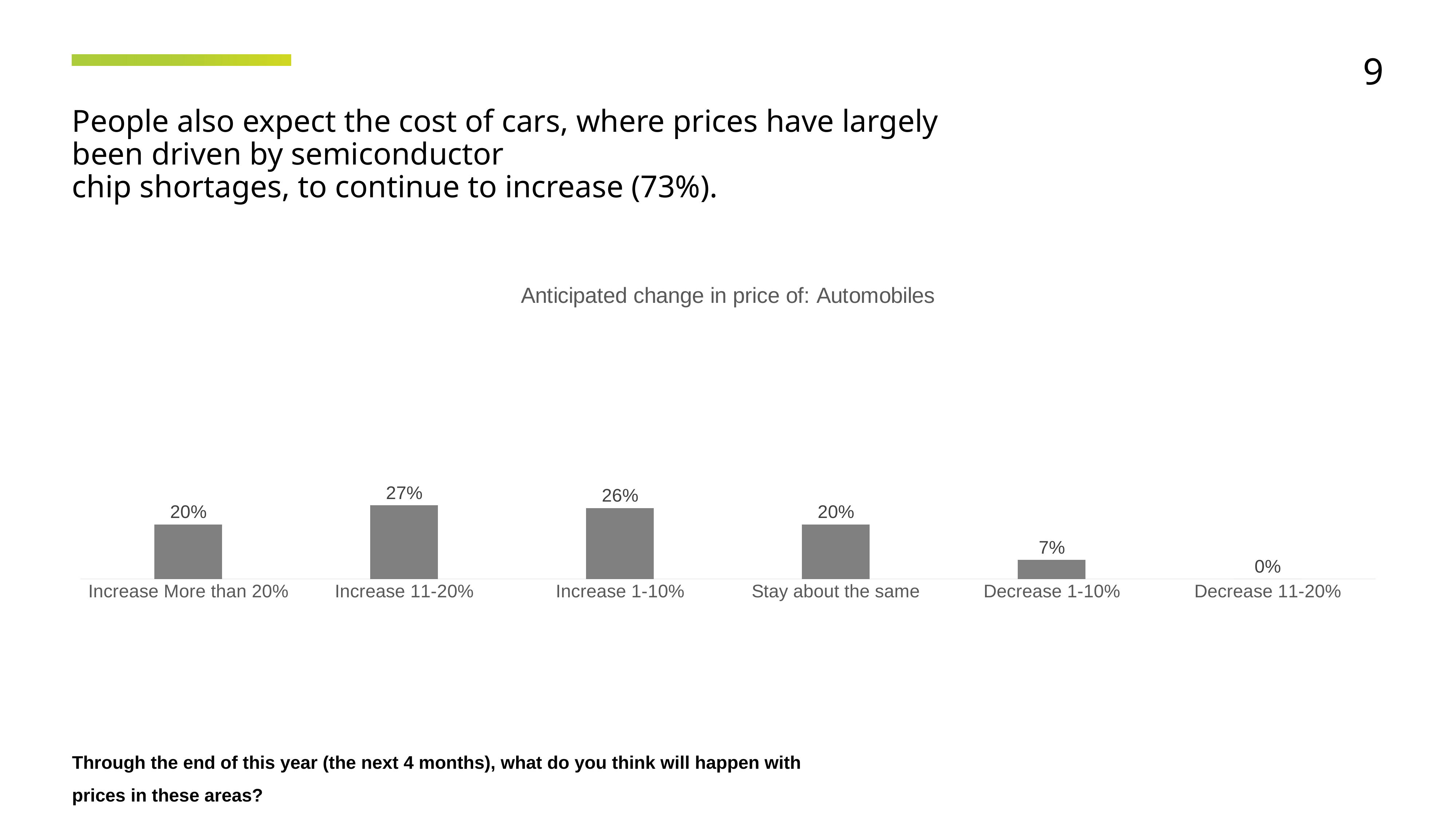
Which category has the highest value? Increase 11-20% What is the value for Stay about the same? 20% What is the value for Decrease 11-20%? 0% What is the total of the values for Increase More than 20%, Increase 11-20% and Increase 1-10%? 73% Which category has the lowest value? Decrease 11-20% What kind of chart is shown? Bar chart Which is larger, the value for Increase More than 20% or the value for Decrease 1-10%? Increase More than 20% What is the title of the chart? Anticipated change in price of: Automobiles What is the value for Decrease 1-10%? 7% What is the difference between the values for Increase 1-10% and Decrease 1-10%? 19% How many categories are shown on the x axis? 6 What is the value for Increase 11-20%? 27%